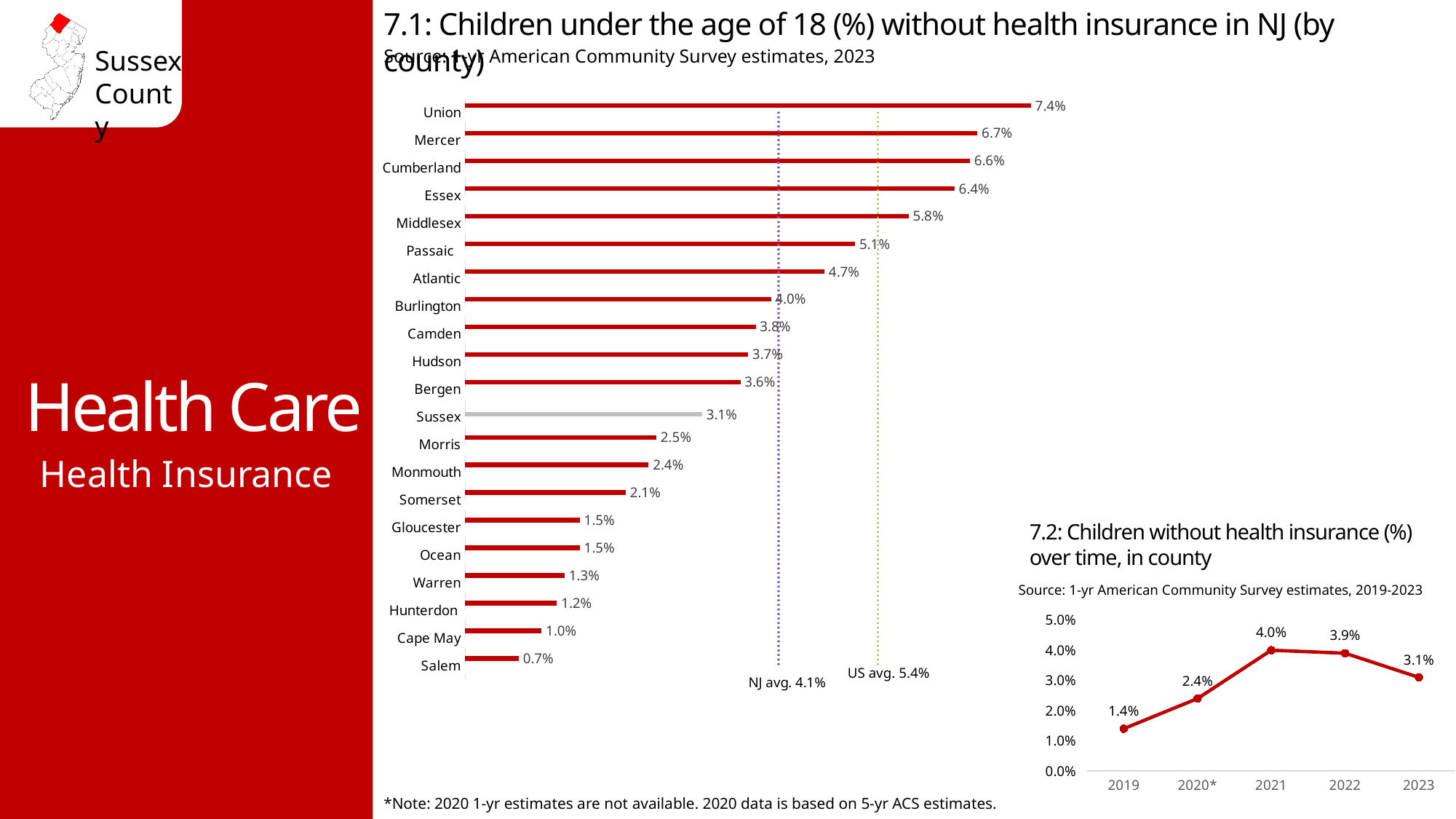
In chart 7.1, what is the NJ average shown by the dotted line? 4.1% What kind of chart is chart 7.1? bar chart What kind of chart is chart 7.2? line chart In chart 7.2, what is the value for 2021? 4.0% In chart 7.1, which county has the highest percentage of children without health insurance? Union In chart 7.2, which year has the lowest value? 2019 In chart 7.1, which is larger, the value for Passaic or the value for Atlantic? Passaic In chart 7.1, what is the difference between the values for Union and Sussex? 4.3% In chart 7.1, which county has the lowest percentage of children without health insurance? Salem In chart 7.1, what is the value for Sussex? 3.1% In chart 7.2, what is the difference between the values for 2022 and 2023? 0.8% In chart 7.1, how many counties are shown? 21